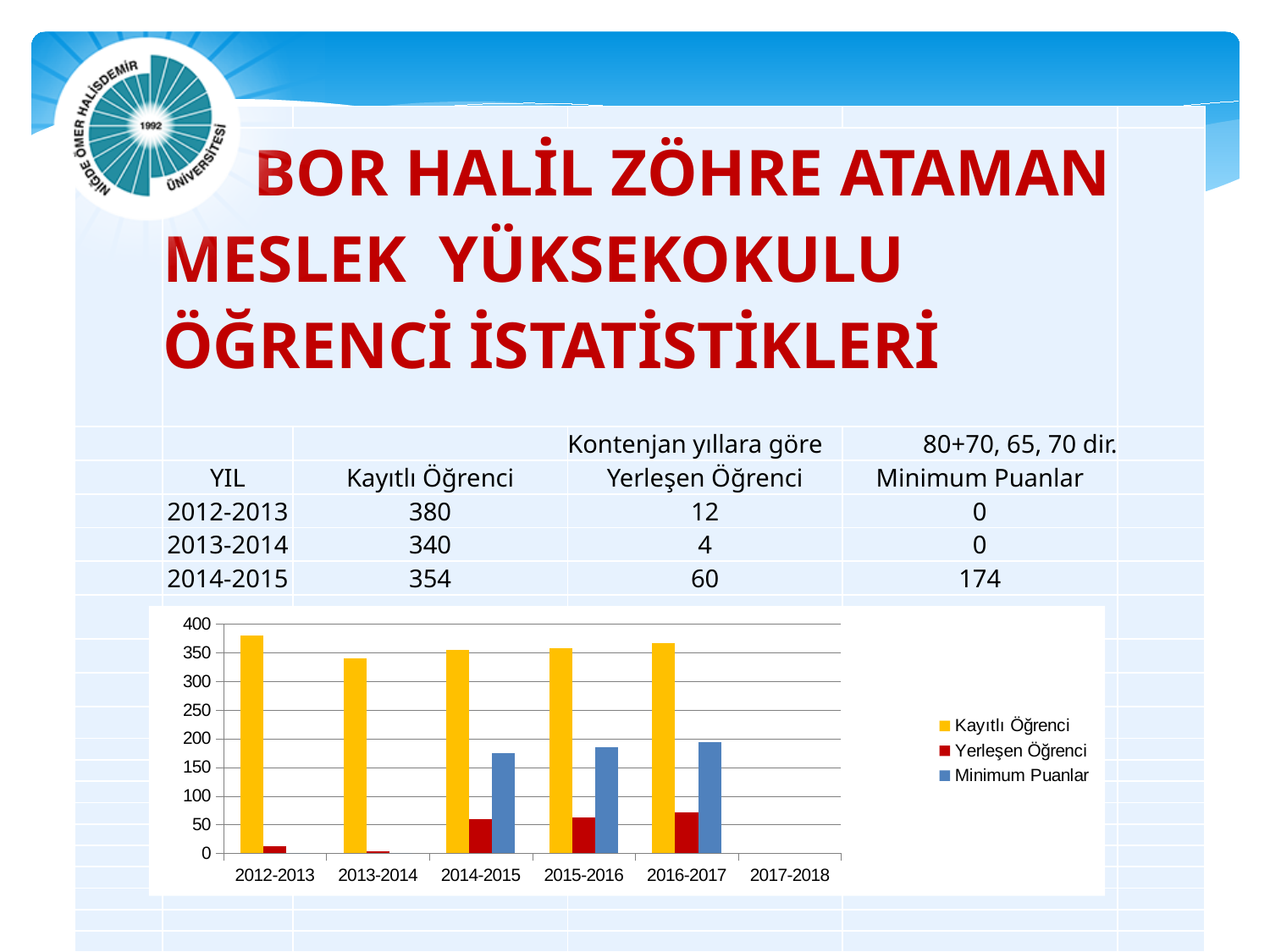
How many year categories are shown on the x axis of the chart? 6 Which is larger, the Yerleşen Öğrenci value for 2014-2015 or for 2012-2013? 2014-2015 Do the Minimum Puanlar values rise or fall from 2012-2013 to 2016-2017? rise Is the Minimum Puanlar value for 2015-2016 greater or less than 150? greater Which year has the highest Kayıtlı Öğrenci bar? 2012-2013 What is the Minimum Puanlar value for 2014-2015? 174 Is the Yerleşen Öğrenci value for 2016-2017 greater or less than 100? less What kind of chart is shown on the slide? bar chart What is the Kayıtlı Öğrenci value for 2012-2013? 380 How many series does the chart legend list? 3 Is the Kayıtlı Öğrenci value for 2016-2017 greater or less than 300? greater What is the difference between the Kayıtlı Öğrenci values for 2012-2013 and 2013-2014? 40